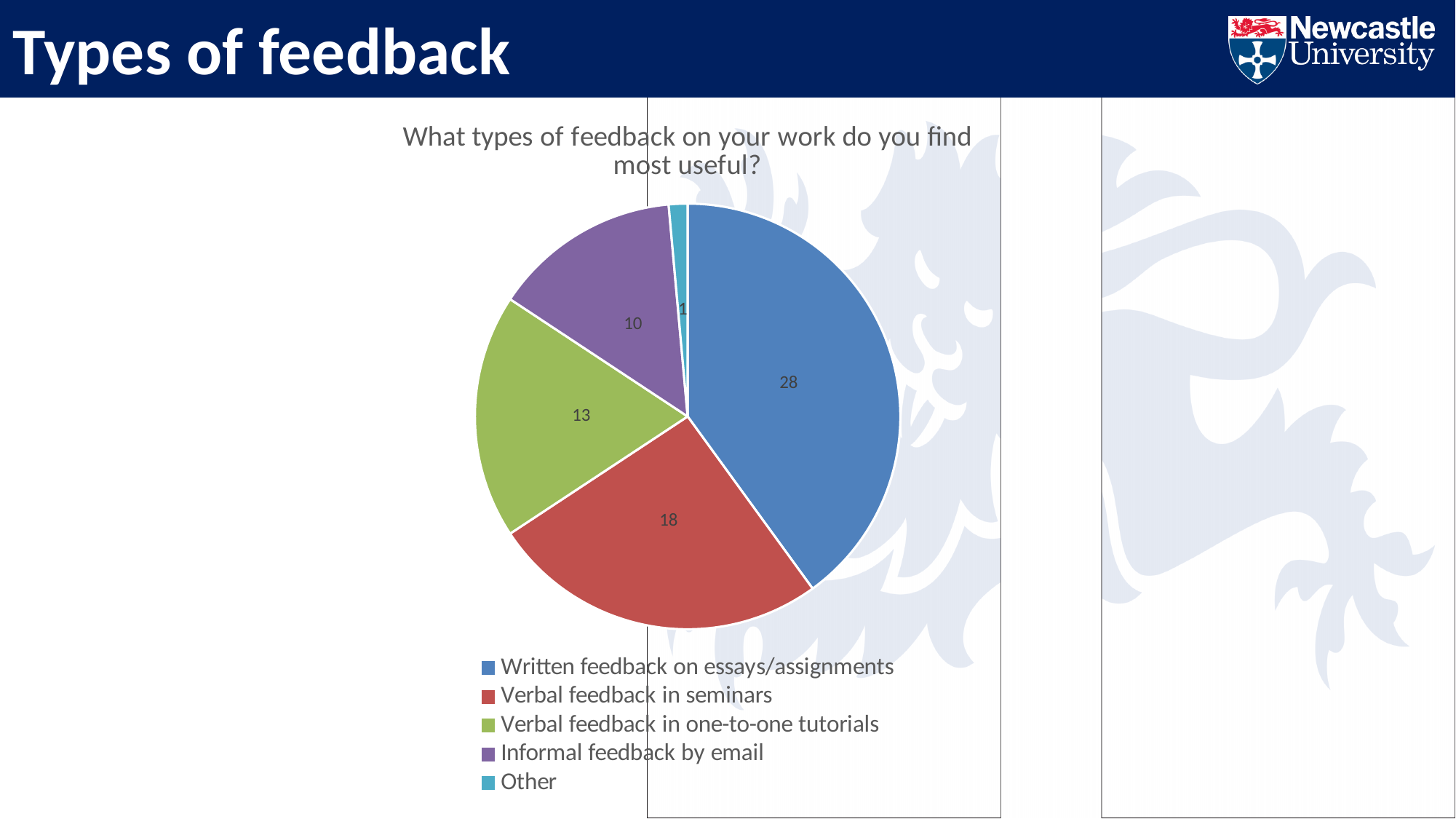
What is the value for Verbal feedback in seminars? 18 Which type of feedback has the smallest slice? Other What is the value for Written feedback on essays/assignments? 28 How many categories does the legend list? 5 What is the value for Other? 1 What is the difference between the values for Written feedback on essays/assignments and Verbal feedback in seminars? 10 Which type of feedback has the largest slice? Written feedback on essays/assignments What kind of chart is shown on the slide? pie chart What is the value for Informal feedback by email? 10 Which is larger: Verbal feedback in one-to-one tutorials or Informal feedback by email? Verbal feedback in one-to-one tutorials What is the title of the chart? What types of feedback on your work do you find most useful? What is the value for Verbal feedback in one-to-one tutorials? 13